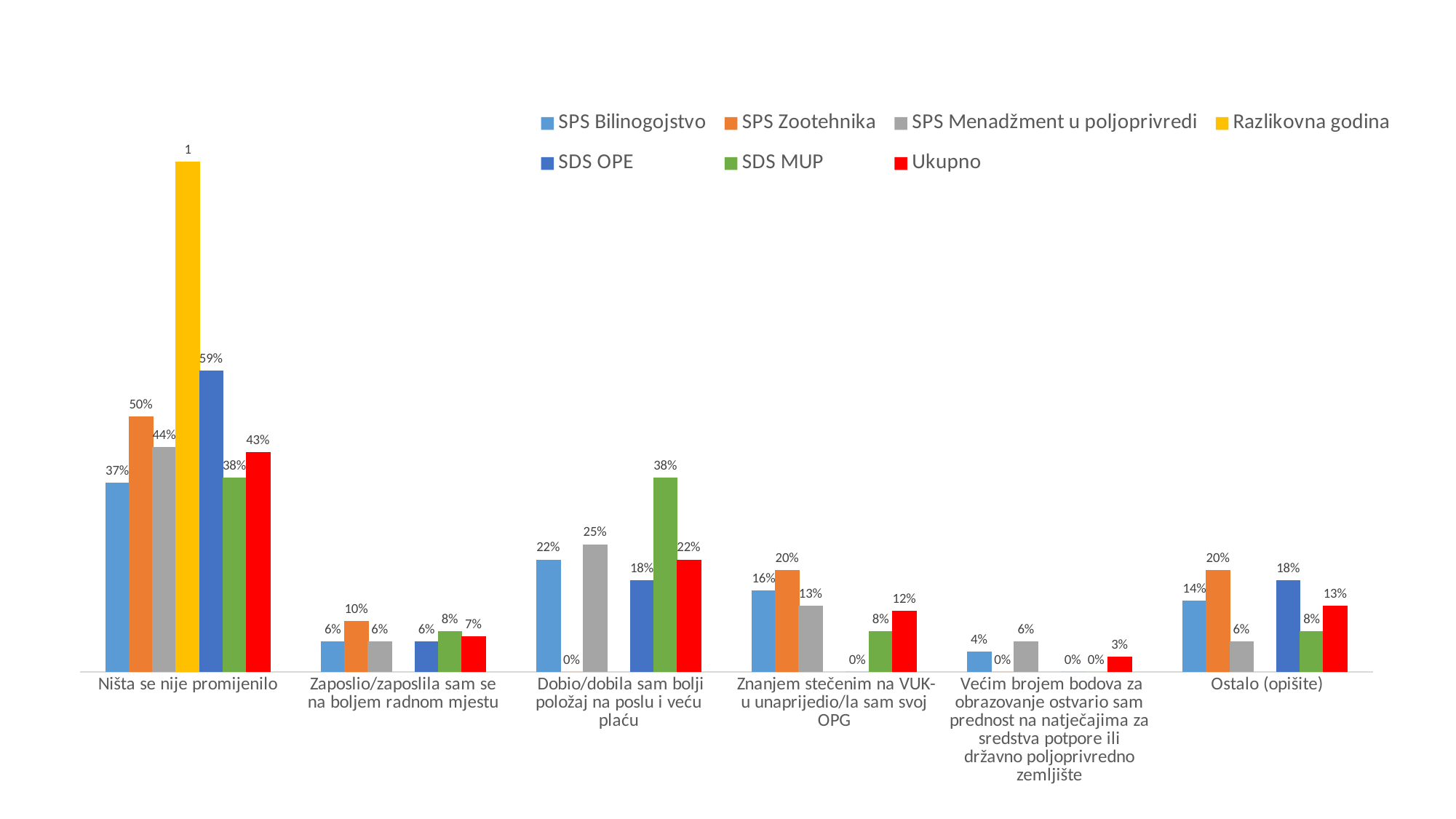
What is the SDS MUP value for the category 'Dobio/dobila sam bolji položaj na poslu i veću plaću'? 38% Which series has the highest value in the category 'Ništa se nije promijenilo'? Razlikovna godina In the category 'Ništa se nije promijenilo', what is the difference between the SDS OPE value and the SPS Bilinogojstvo value? 22 percentage points What is the SPS Bilinogojstvo value for the category 'Znanjem stečenim na VUK-u unaprijedio/la sam svoj OPG'? 16% What is the Ukupno value for the category 'Većim brojem bodova za obrazovanje ostvario sam prednost na natječajima za sredstva potpore ili državno poljoprivredno zemljište'? 3% How many series does the legend list? 7 What kind of chart is shown on the slide? bar chart What colour represents the Ukupno series in the legend? red What is the Ukupno value for the category 'Ništa se nije promijenilo'? 43% How many categories are shown along the x axis? 6 In the category 'Ništa se nije promijenilo', which is larger: SPS Zootehnika or SPS Menadžment u poljoprivredi? SPS Zootehnika What is the SPS Zootehnika value for the category 'Ostalo (opišite)'? 20%